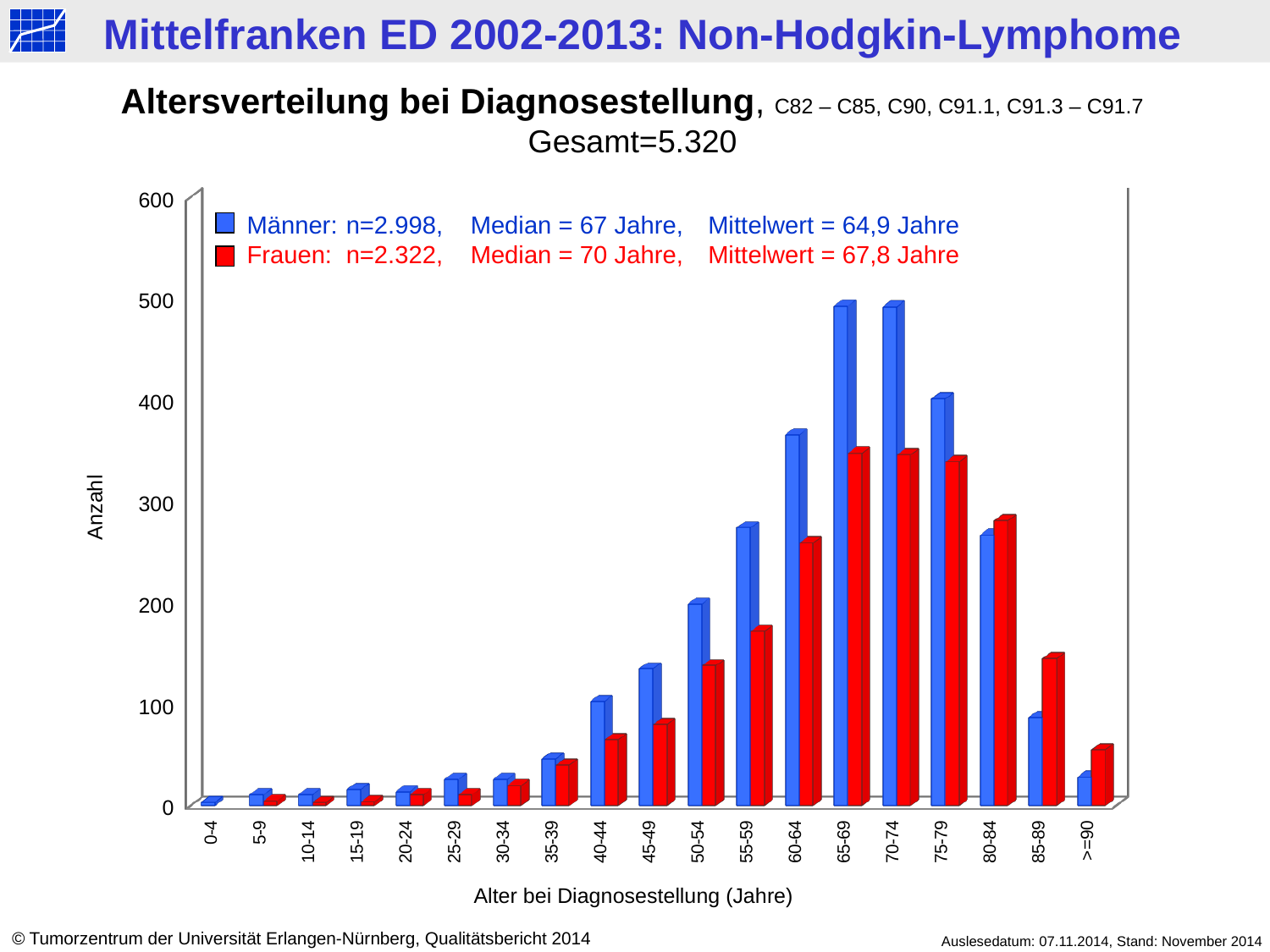
Is the Frauen value for 70-74 greater or less than 300? greater Is the Männer value for 55-59 greater or less than 200? greater Do the Männer values rise or fall from 70-74 to >=90? fall According to the legend, what is the median age for Frauen? 70 Jahre Is the Frauen value for 55-59 greater or less than 200? less Which is larger for the 60-64 age group, the Männer value or the Frauen value? Männer What kind of chart is shown on the slide? bar chart How many series does the legend list? 2 How many age categories are shown on the x axis? 19 Which is larger for the 85-89 age group, the Männer value or the Frauen value? Frauen